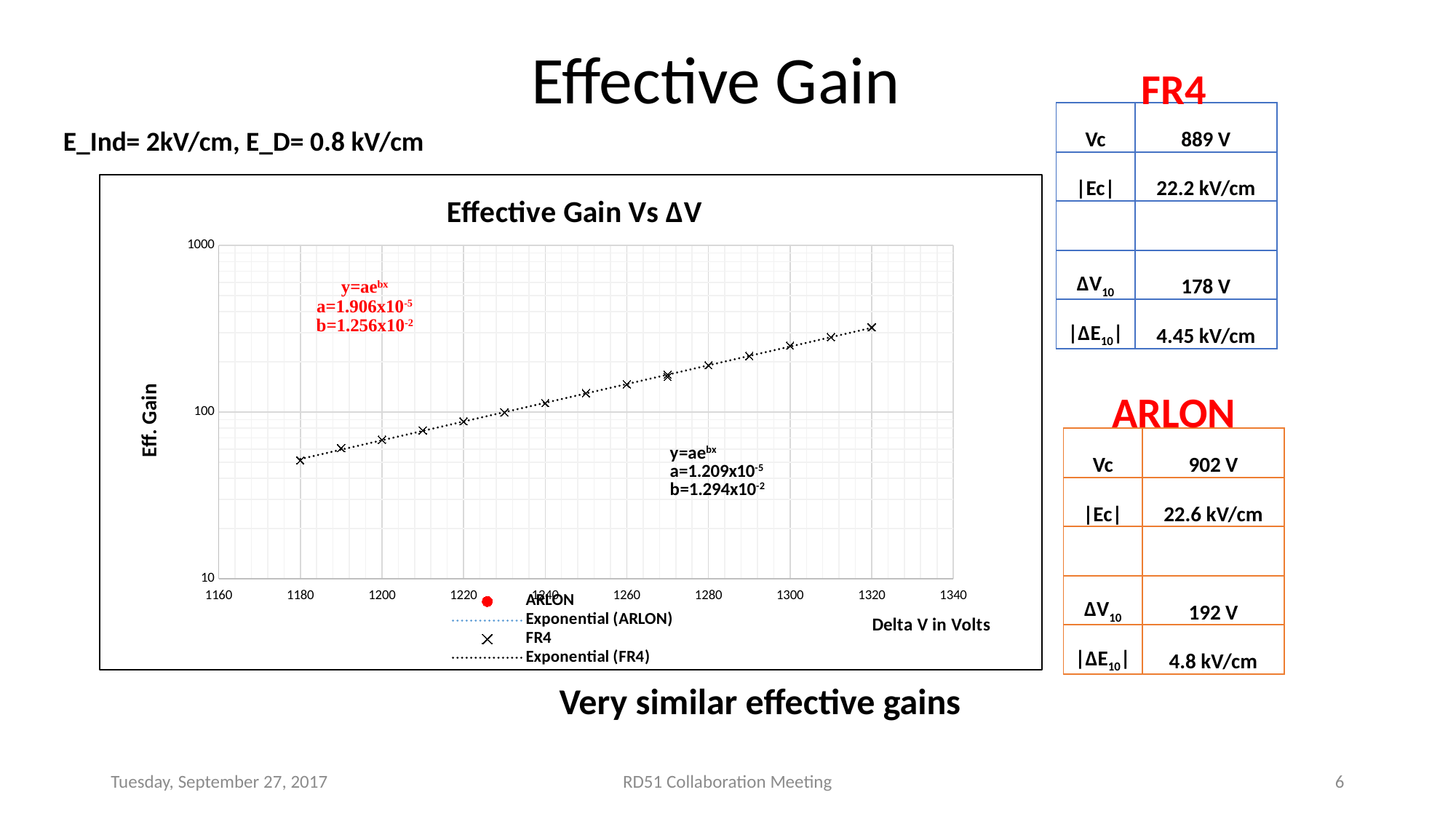
Is the FR4 effective gain at Delta V = 1320 V greater or less than 100? greater What is the title of the chart? Effective Gain Vs ΔV How many series does the chart legend list? 4 Which has the larger effective gain on the chart: the point at Delta V = 1180 V or the point at Delta V = 1320 V? 1320 V What is the highest value shown on the x axis of the chart? 1340 What is the lowest value shown on the y axis of the chart? 10 What kind of chart is shown on the slide? scatter chart Is the FR4 effective gain at Delta V = 1180 V greater or less than 100? less Does the effective gain rise or fall as Delta V increases along the x axis? rise Is the FR4 effective gain at Delta V = 1300 V greater or less than 1000? less What is the label of the y axis of the chart? Eff. Gain